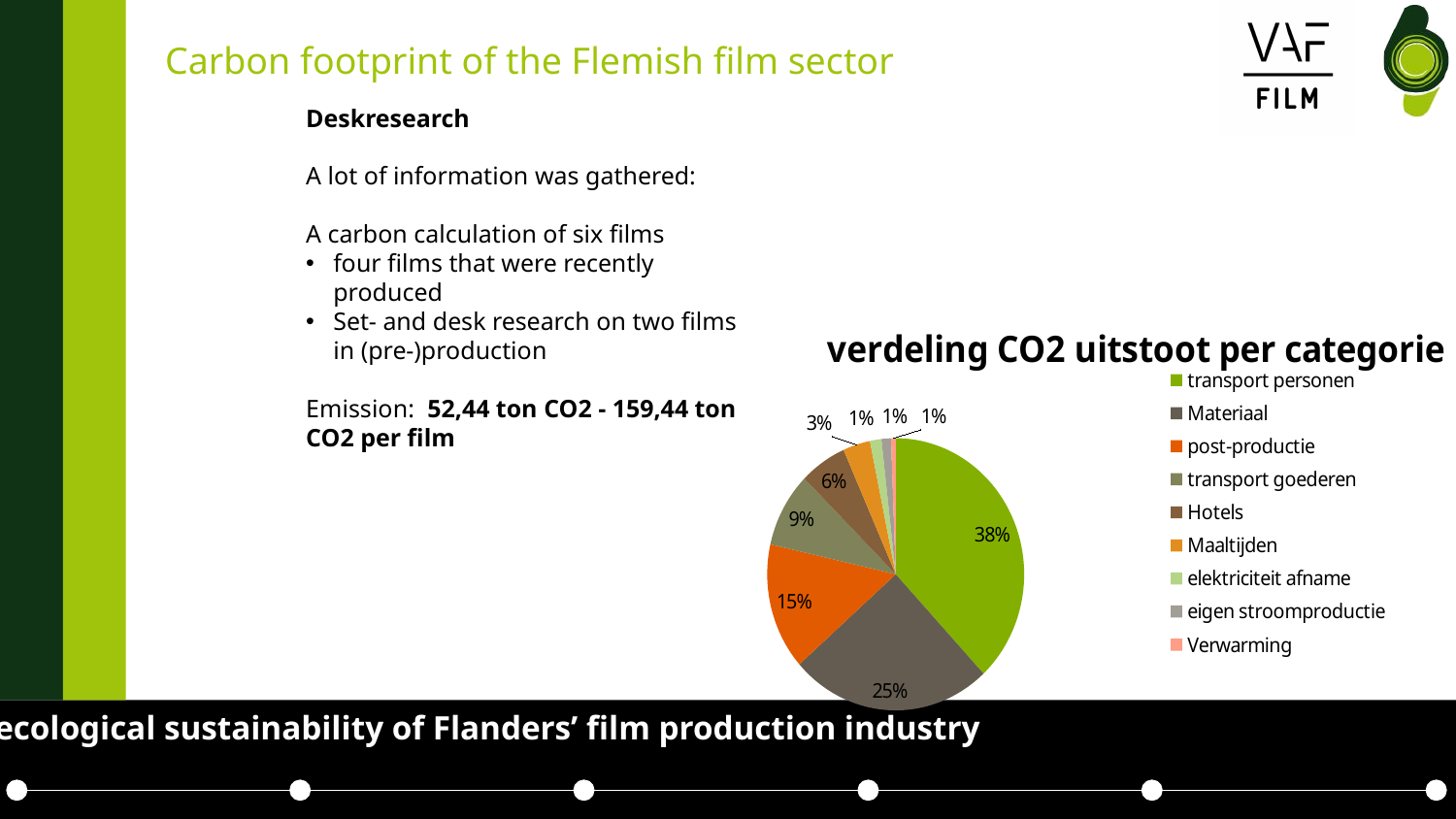
What percentage is shown for 'Hotels'? 6% What percentage is shown for 'Maaltijden'? 3% What is the difference in percentage points between 'transport personen' and 'Materiaal'? 13 Which category has the largest share of the pie? transport personen What percentage is shown for 'Materiaal'? 25% What share of the pie does 'transport personen' account for? 38% What is the combined share of 'transport personen' and 'Materiaal'? 63% What type of chart is shown on the slide? pie chart What percentage is shown for 'post-productie'? 15% Which has a larger share, 'post-productie' or 'transport goederen'? post-productie What is the title of the chart? verdeling CO2 uitstoot per categorie How many categories does the legend of the pie chart list? 9